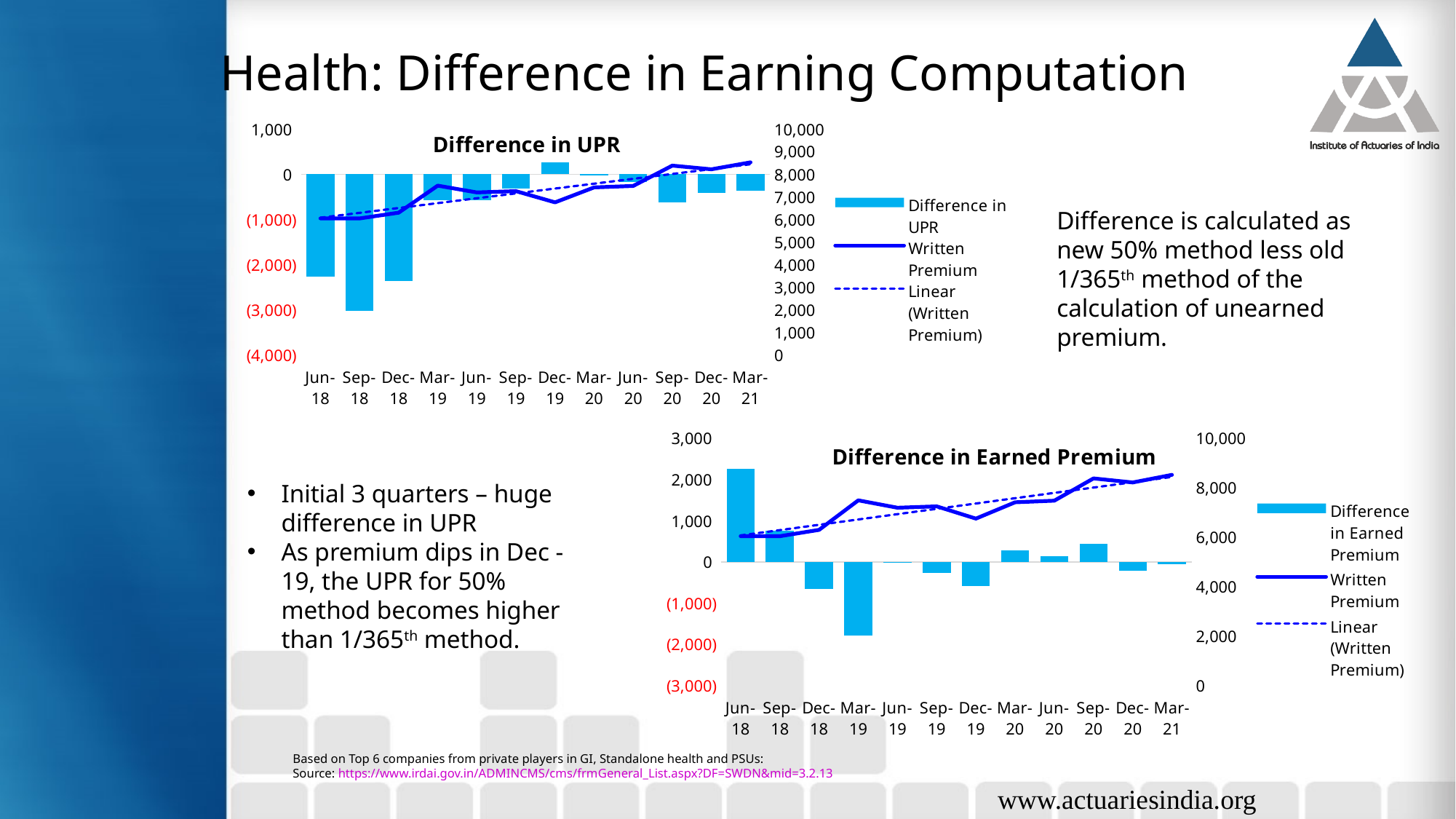
How many series does the legend of the "Difference in Earned Premium" chart list? 3 What type of chart is the "Difference in UPR" chart? Combined bar and line chart In the "Difference in UPR" chart, does the Written Premium line generally rise or fall from Jun-18 to Mar-21? Rise In the "Difference in Earned Premium" chart, is the Difference in Earned Premium for Jun-18 greater or less than 1,000? greater How many quarters are shown on the x axis of the "Difference in UPR" chart? 12 In the "Difference in Earned Premium" chart, which is larger: the Difference in Earned Premium for Sep-20 or for Dec-20? Sep-20 In the "Difference in UPR" chart, which quarter has the lowest Difference in UPR? Sep-18 In the "Difference in UPR" chart, is the Difference in UPR for Sep-18 greater or less than (2,000)? less In the "Difference in Earned Premium" chart, which quarter has the highest Difference in Earned Premium? Jun-18 In the "Difference in UPR" chart, which quarter has the highest Difference in UPR? Dec-19 In the "Difference in Earned Premium" chart, which quarter has the lowest Difference in Earned Premium? Mar-19 In the "Difference in UPR" chart, is the Written Premium for Mar-21 greater or less than 8,000? greater